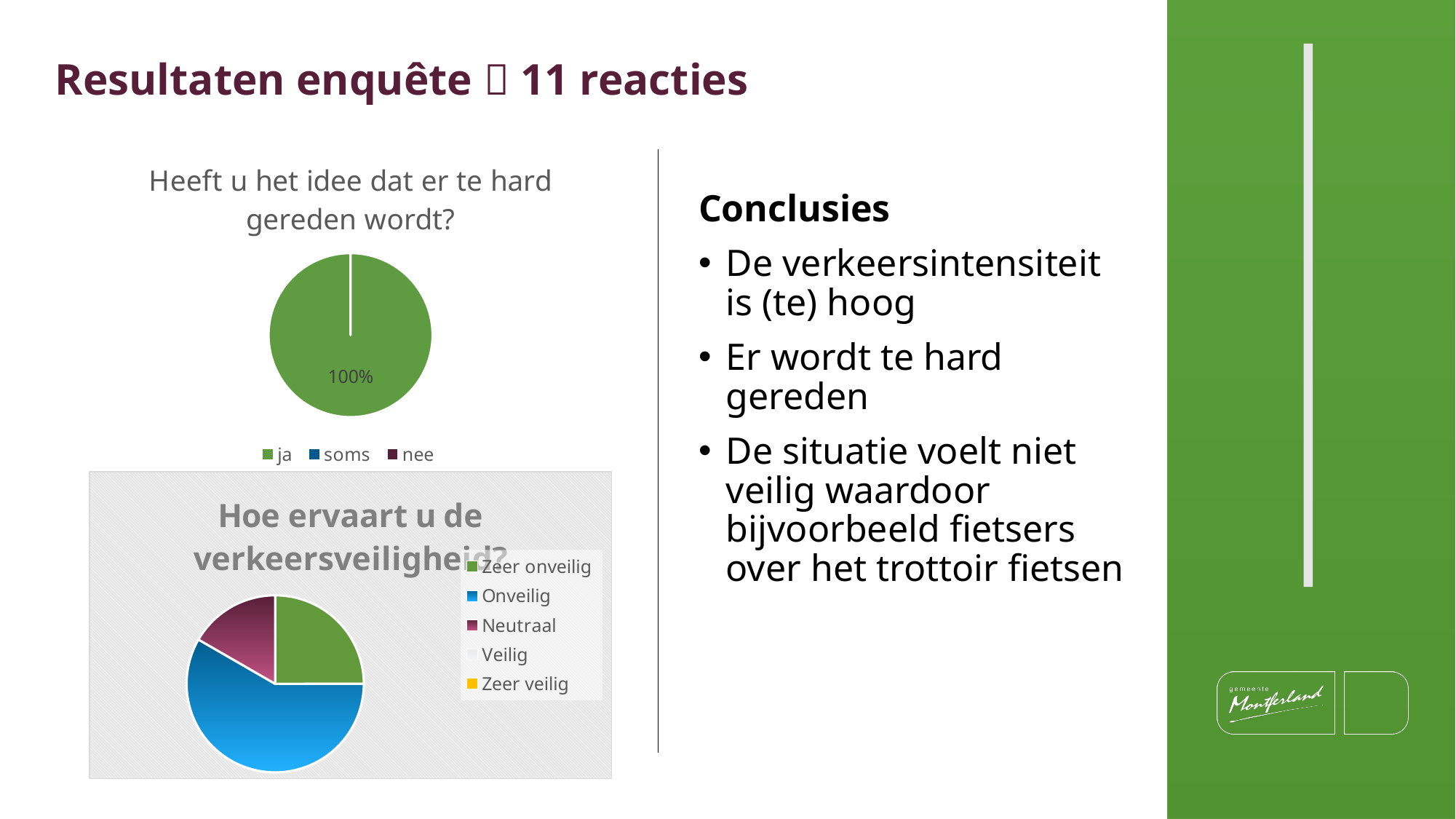
In the chart "Hoe ervaart u de verkeersveiligheid?", which category has the largest slice? Onveilig What kind of chart is the chart titled "Heeft u het idee dat er te hard gereden wordt?"? pie chart In the chart "Hoe ervaart u de verkeersveiligheid?", which slice is larger: Onveilig or Neutraal? Onveilig How many entries does the legend of the chart "Heeft u het idee dat er te hard gereden wordt?" list? 3 How many entries does the legend of the chart "Hoe ervaart u de verkeersveiligheid?" list? 5 In the chart "Heeft u het idee dat er te hard gereden wordt?", which category has the largest share? ja In the chart "Heeft u het idee dat er te hard gereden wordt?", what share of the pie is "ja"? 100% What kind of chart is the chart titled "Hoe ervaart u de verkeersveiligheid?"? pie chart What is the title of the lower pie chart on the slide? Hoe ervaart u de verkeersveiligheid? In the chart "Hoe ervaart u de verkeersveiligheid?", which slice is larger: Onveilig or Zeer onveilig? Onveilig In the chart "Hoe ervaart u de verkeersveiligheid?", what colour is the Onveilig slice? blue